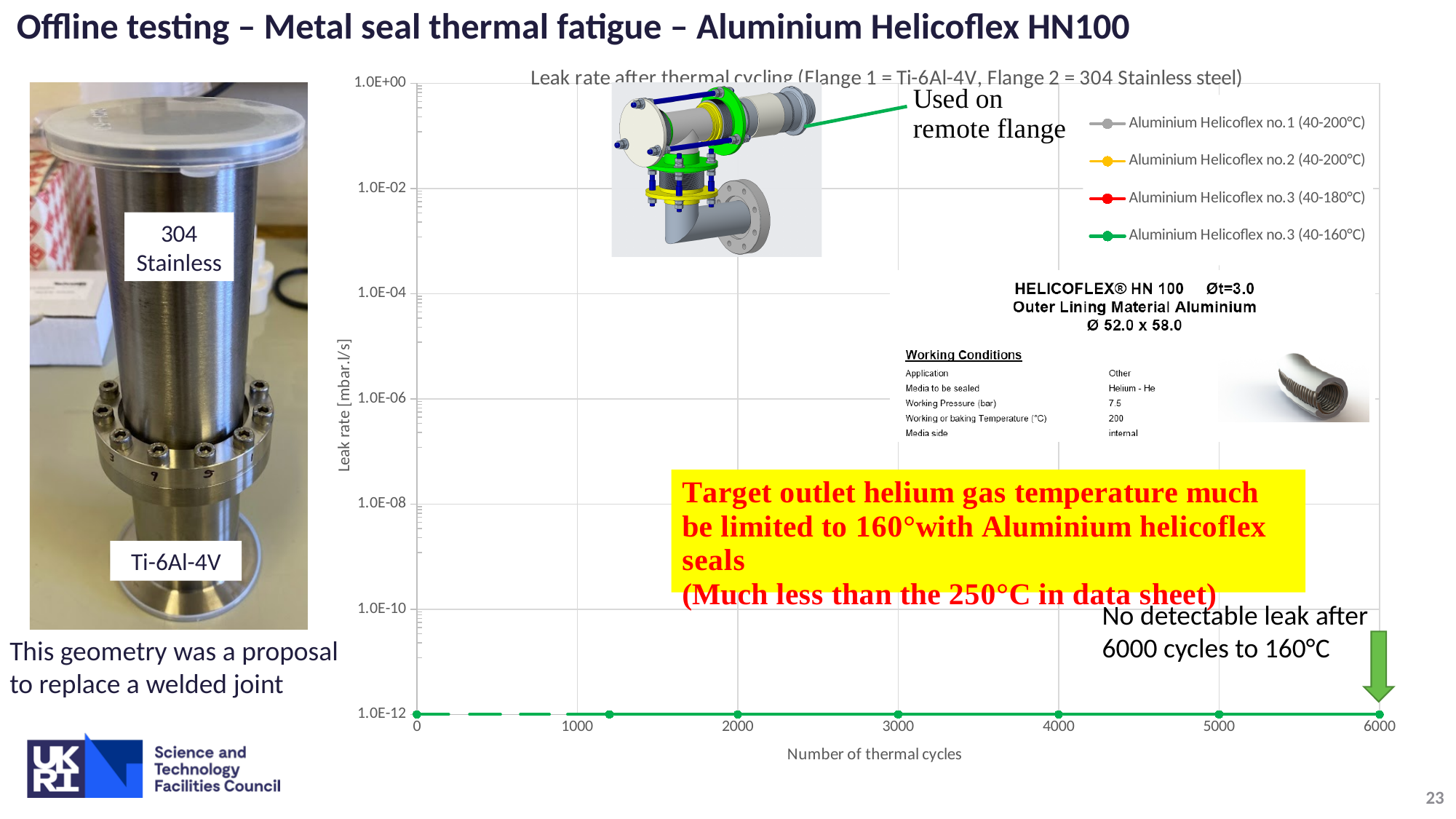
What is the title of the chart? Leak rate after thermal cycling (Flange 1 = Ti-6Al-4V, Flange 2 = 304 Stainless steel) What is the maximum number of thermal cycles shown on the x axis? 6000 What is the highest value shown on the y axis of the chart? 1.0E+00 Which series in the legend is plotted in green? Aluminium Helicoflex no.3 (40-160°C) What kind of chart is shown on the slide? Line chart Does the leak rate for Aluminium Helicoflex no.3 (40-160°C) rise, fall or stay flat as the number of thermal cycles increases from 0 to 6000? Stays flat How many series does the chart legend list? 4 What is the leak rate for Aluminium Helicoflex no.3 (40-160°C) at 6000 thermal cycles? 1.0E-12 Is the leak rate for Aluminium Helicoflex no.3 (40-160°C) at 6000 cycles greater or less than 1.0E-10? less What is the lowest value shown on the y axis of the chart? 1.0E-12 What is the leak rate for Aluminium Helicoflex no.3 (40-160°C) at 3000 thermal cycles? 1.0E-12 What is the label of the x axis of the chart? Number of thermal cycles